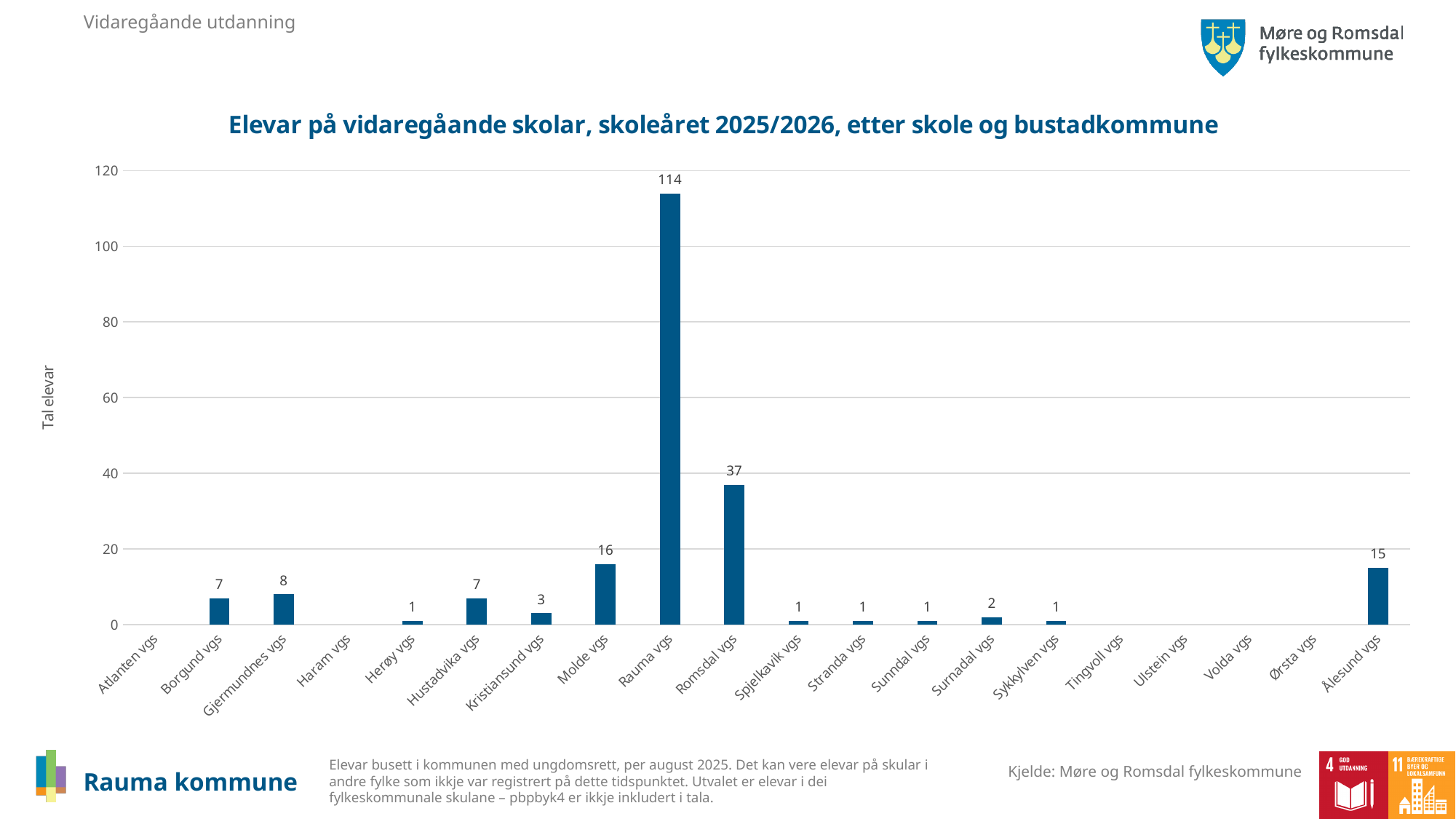
What is the value for Romsdal vgs? 37 What is the difference between the values for Molde vgs and Kristiansund vgs? 13 How many students are shown for Rauma vgs? 114 Which has a larger value, Molde vgs or Ålesund vgs? Molde vgs What is the difference between the values for Rauma vgs and Romsdal vgs? 77 Is the value for Rauma vgs greater or less than 100? greater What is the value for Gjermundnes vgs? 8 What is the label on the vertical axis? Tal elevar What is the value for Surnadal vgs? 2 How many schools are listed on the x axis? 20 What kind of chart is shown on the slide? Bar chart Which school has the highest number of students? Rauma vgs